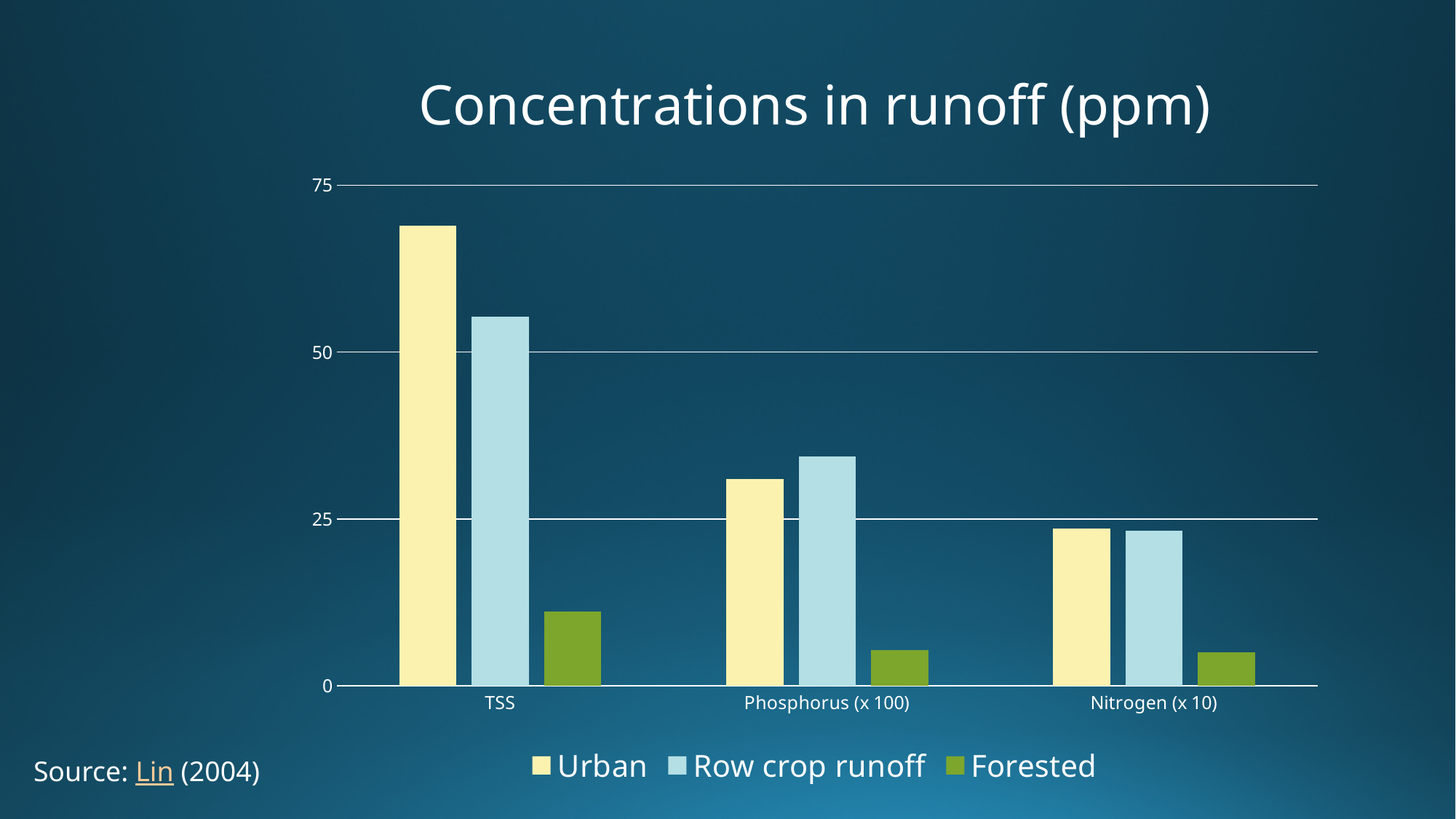
Which category has the highest Urban value? TSS What kind of chart is shown on the slide? bar chart For TSS, which is larger: the Urban value or the Row crop runoff value? Urban Do the Urban values rise or fall from TSS to Nitrogen (x 10)? fall For Phosphorus (x 100), which is larger: the Urban value or the Row crop runoff value? Row crop runoff Which series has the lowest value for TSS? Forested How many series does the legend list? 3 What is the title of the chart? Concentrations in runoff (ppm) Is the Row crop runoff value for Nitrogen (x 10) greater or less than 25? less Is the Forested value for Phosphorus (x 100) greater or less than 25? less How many categories are shown on the x axis? 3 Is the Urban value for TSS greater or less than 50? greater